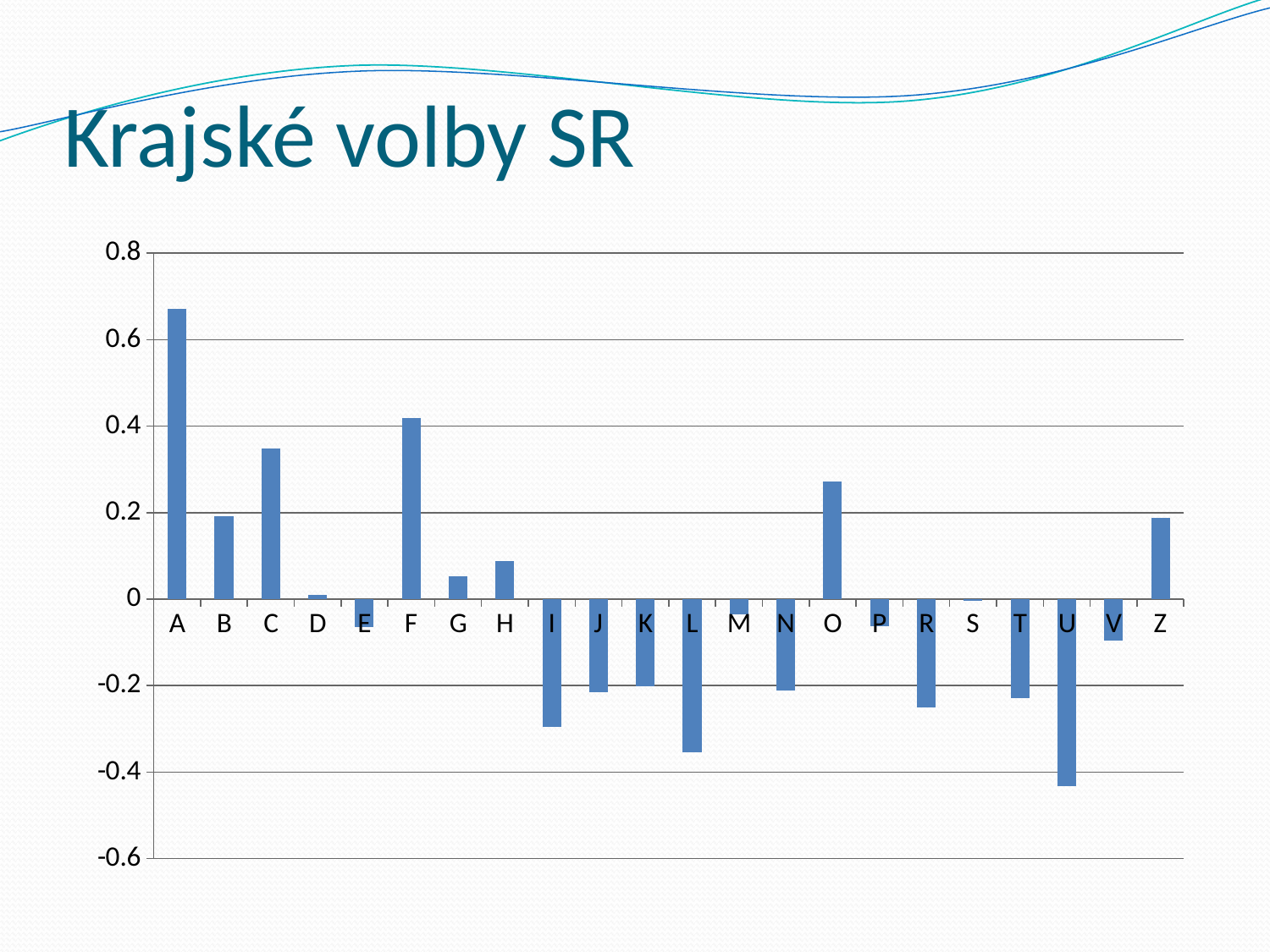
What is the title of the slide containing the chart? Krajské volby SR What kind of chart is shown on the slide? bar chart How many categories are plotted on the x axis of the chart? 22 Is the value for L greater or less than -0.2? less Is the value for C greater or less than 0.4? less Is the value for F greater or less than 0.4? greater Which category has the lowest value in the chart? U Which has the larger value, C or B? C Which category has the highest value in the chart? A Which has the larger value, O or Z? O